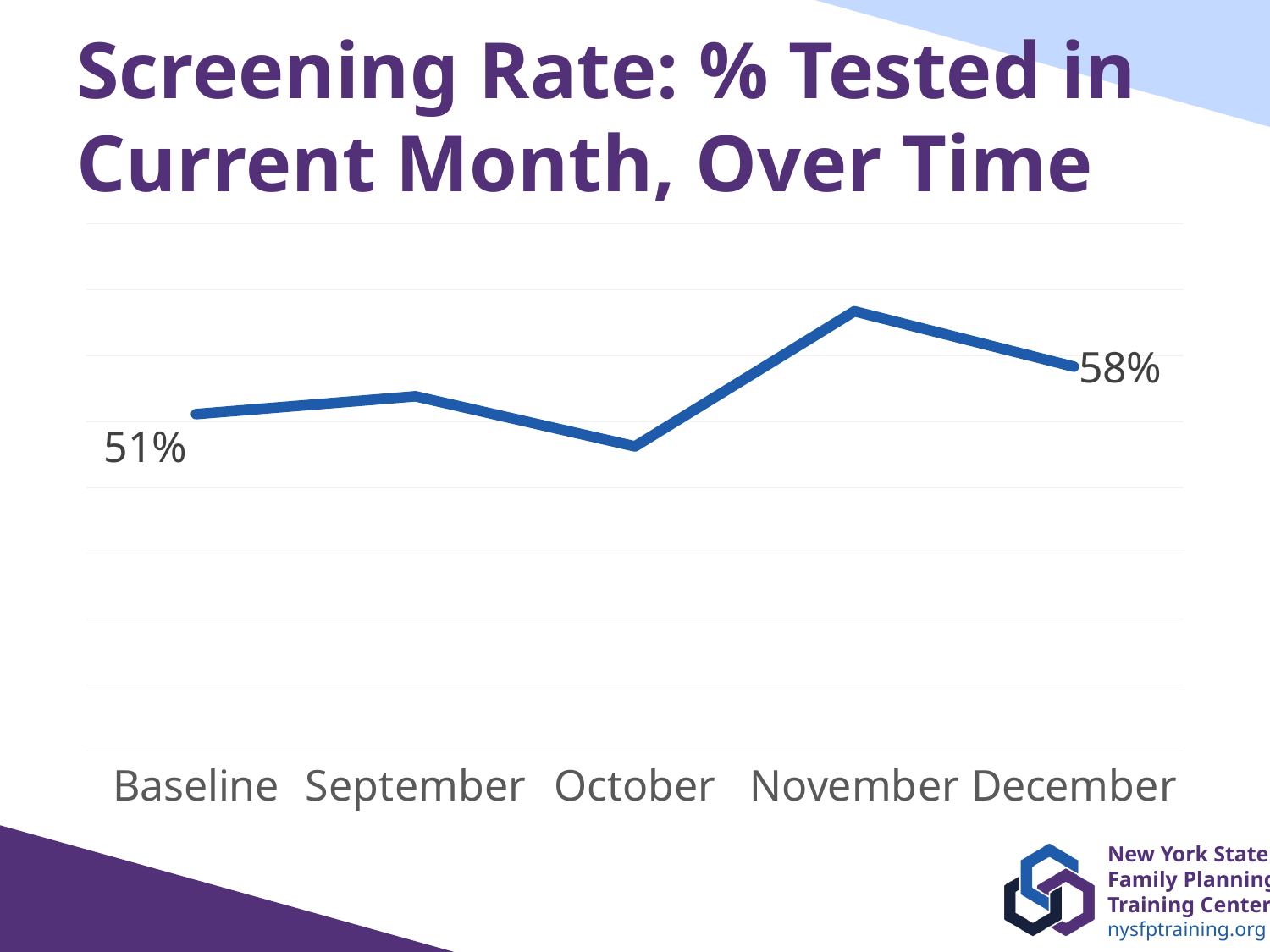
Which is larger, the screening rate in December or at Baseline? December What is the screening rate at Baseline? 51% How many time points are plotted on the chart? 5 By how many percentage points does the December screening rate exceed the Baseline rate? 7 percentage points What kind of chart is shown on the slide? Line chart Which point on the chart has the lowest screening rate? October Overall, does the screening rate rise or fall from Baseline to December? Rise Which is larger, the screening rate in October or in September? September Which is larger, the screening rate in November or in September? November Which month has the highest screening rate? November What is the screening rate in December? 58% What is the title of the slide's chart? Screening Rate: % Tested in Current Month, Over Time